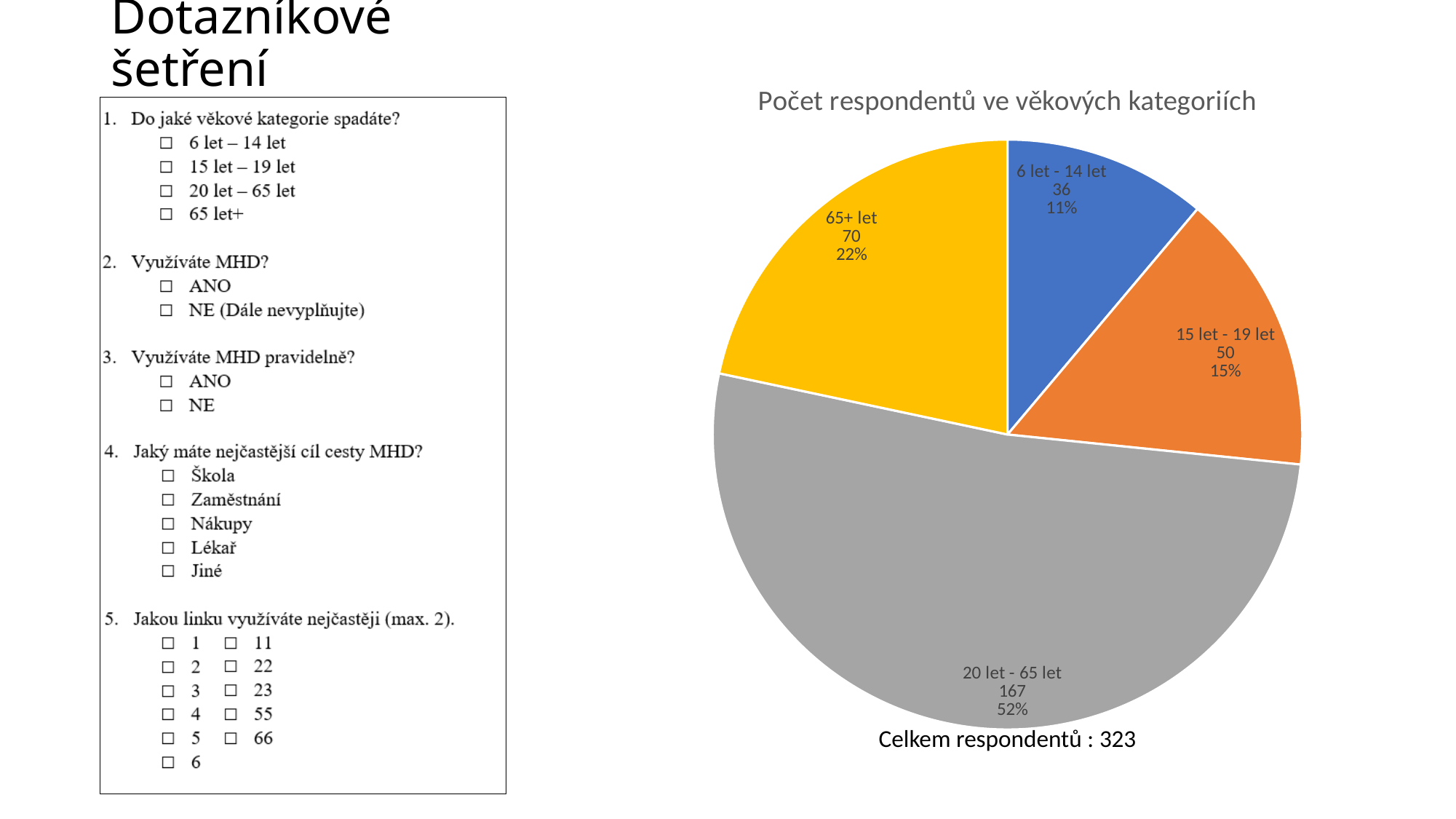
How many age categories does the pie chart show? 4 What is the difference in respondents between the 65+ let and 15 let - 19 let categories? 20 How many respondents are in the 20 let - 65 let category? 167 What is the title of the chart? Počet respondentů ve věkových kategoriích How many respondents are in the 6 let - 14 let category? 36 Which age category has the fewest respondents? 6 let - 14 let What share of the pie does the 15 let - 19 let category represent? 15% Which age category has the most respondents? 20 let - 65 let Which category has more respondents, 65+ let or 6 let - 14 let? 65+ let What type of chart is shown on the slide? pie chart What share of the pie does the 20 let - 65 let category represent? 52% How many respondents are in the 65+ let category? 70